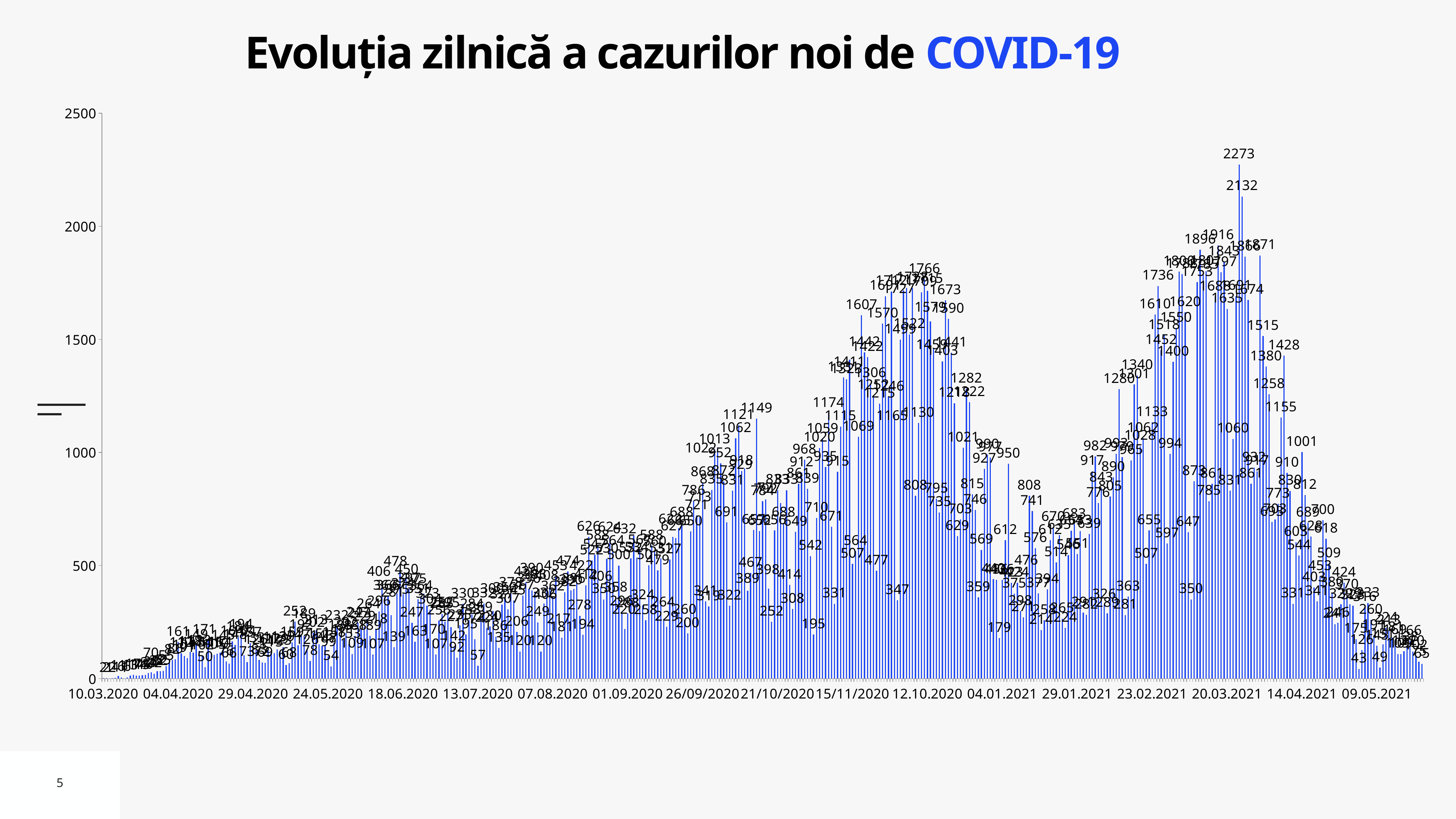
How many date labels are shown on the x axis? 18 What is the last date label shown on the x axis? 09.05.2021 What is the highest value labelled on the y axis? 2500 Is the highest bar on the chart greater or less than 2000? greater What is the first date label shown on the x axis? 10.03.2020 What is the difference between the two highest labelled values, 2273 and 2132? 141 What kind of chart is shown on the slide? bar chart Is the peak of the late-2020 wave (labelled 1766) greater or less than 2000? less Which is larger: the peak of the late-2020 wave labelled 1766 or the peak of the 2021 wave labelled 2273? 2273 What is the highest daily value labelled on the chart? 2273 What is the second-highest value labelled on the chart, next to the 2273 peak? 2132 What is the title of the chart? Evoluția zilnică a cazurilor noi de COVID-19